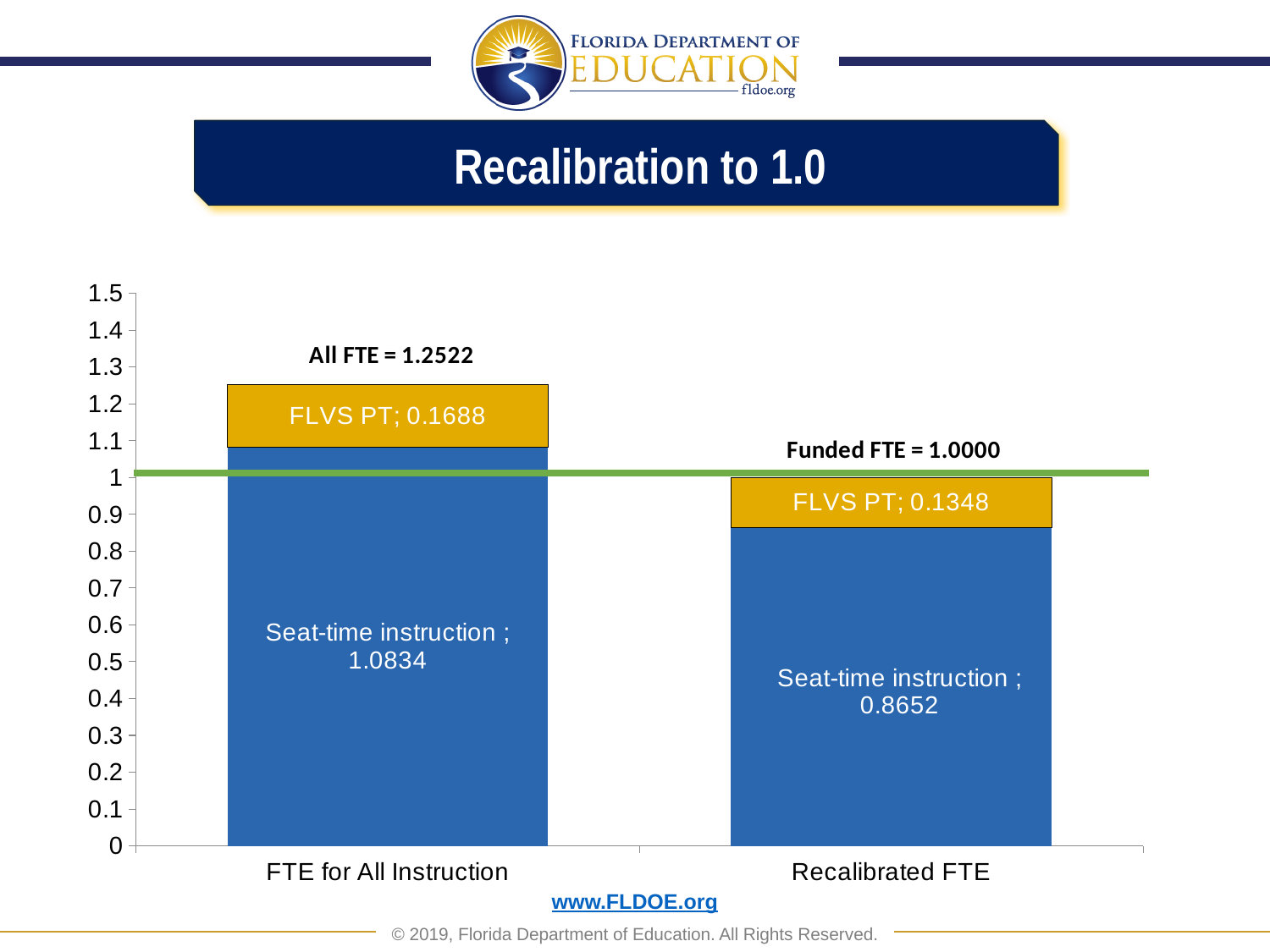
What is the FLVS PT value for Recalibrated FTE? 0.1348 Which category has the larger FLVS PT value, FTE for All Instruction or Recalibrated FTE? FTE for All Instruction What is the Seat-time instruction value for FTE for All Instruction? 1.0834 What is the Seat-time instruction value for Recalibrated FTE? 0.8652 What is the total of the stacked bar for Recalibrated FTE? 1.0000 What kind of chart is shown on the slide? Stacked bar chart What is the title of the slide containing the chart? Recalibration to 1.0 What is the difference between the Seat-time instruction values for FTE for All Instruction and Recalibrated FTE? 0.2182 What is the FLVS PT value for FTE for All Instruction? 0.1688 How many categories are shown on the x axis? 2 What is the total of the stacked bar for FTE for All Instruction? 1.2522 Is the total for FTE for All Instruction greater or less than 1.2? greater